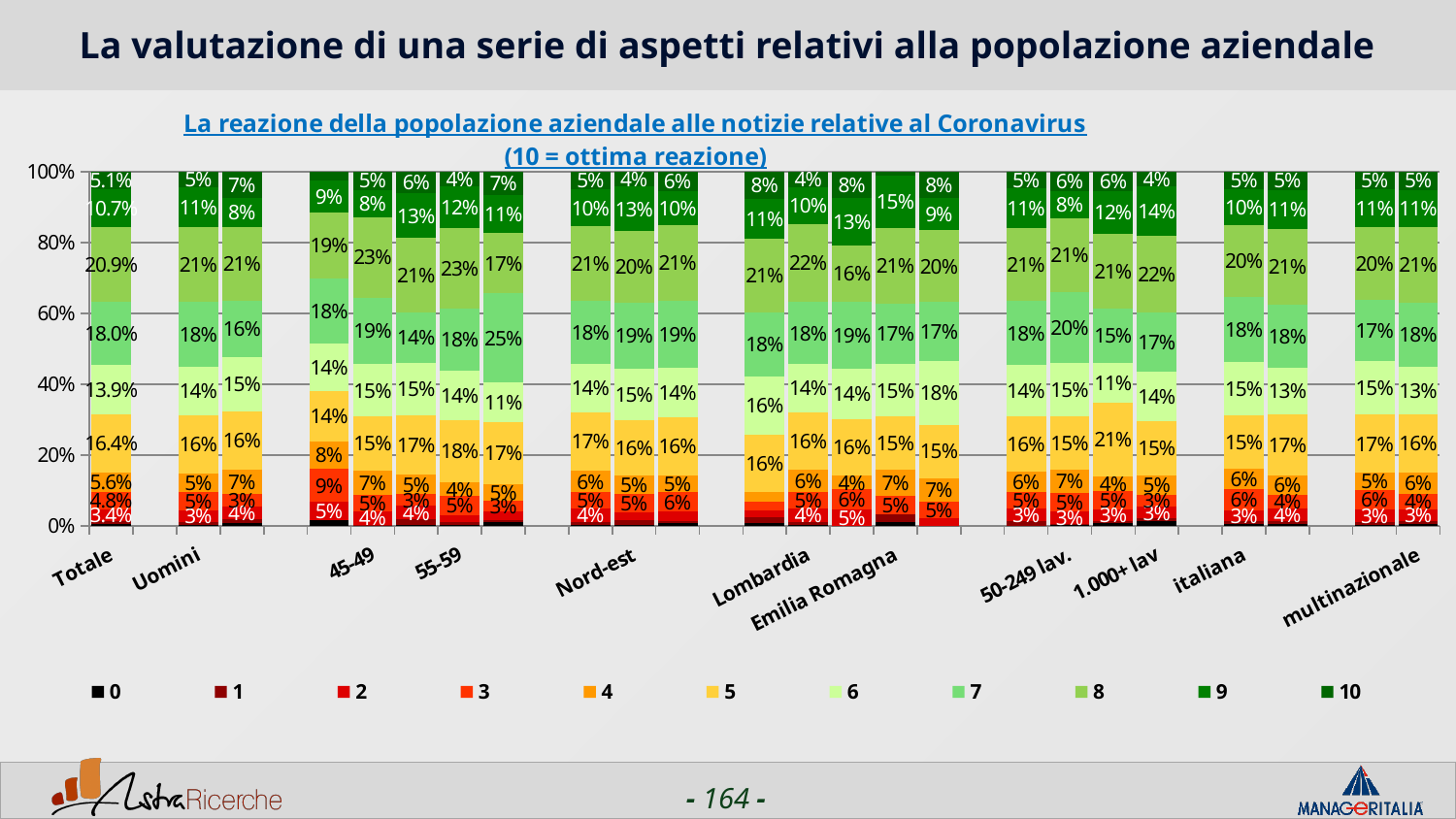
In the Totale bar, what is the share for score 7? 18.0% What is the title of the chart? La reazione della popolazione aziendale alle notizie relative al Coronavirus (10 = ottima reazione) In the Totale bar, what is the share for score 6? 13.9% What type of chart is shown on the slide? Stacked bar chart In the Totale bar, what is the share for score 10 (the top segment)? 5.1% How many series does the legend list? 11 In the Totale bar, what is the difference between the share for score 8 and the share for score 7? 2.9 percentage points In the Totale bar, what is the share for score 8? 20.9% In the Uomini bar, what is the share for score 9? 11% In the Totale bar, which score has the largest share? 8 According to the chart subtitle, what does a score of 10 represent? Ottima reazione In the Uomini bar, what is the share for score 10 (the top segment)? 5%